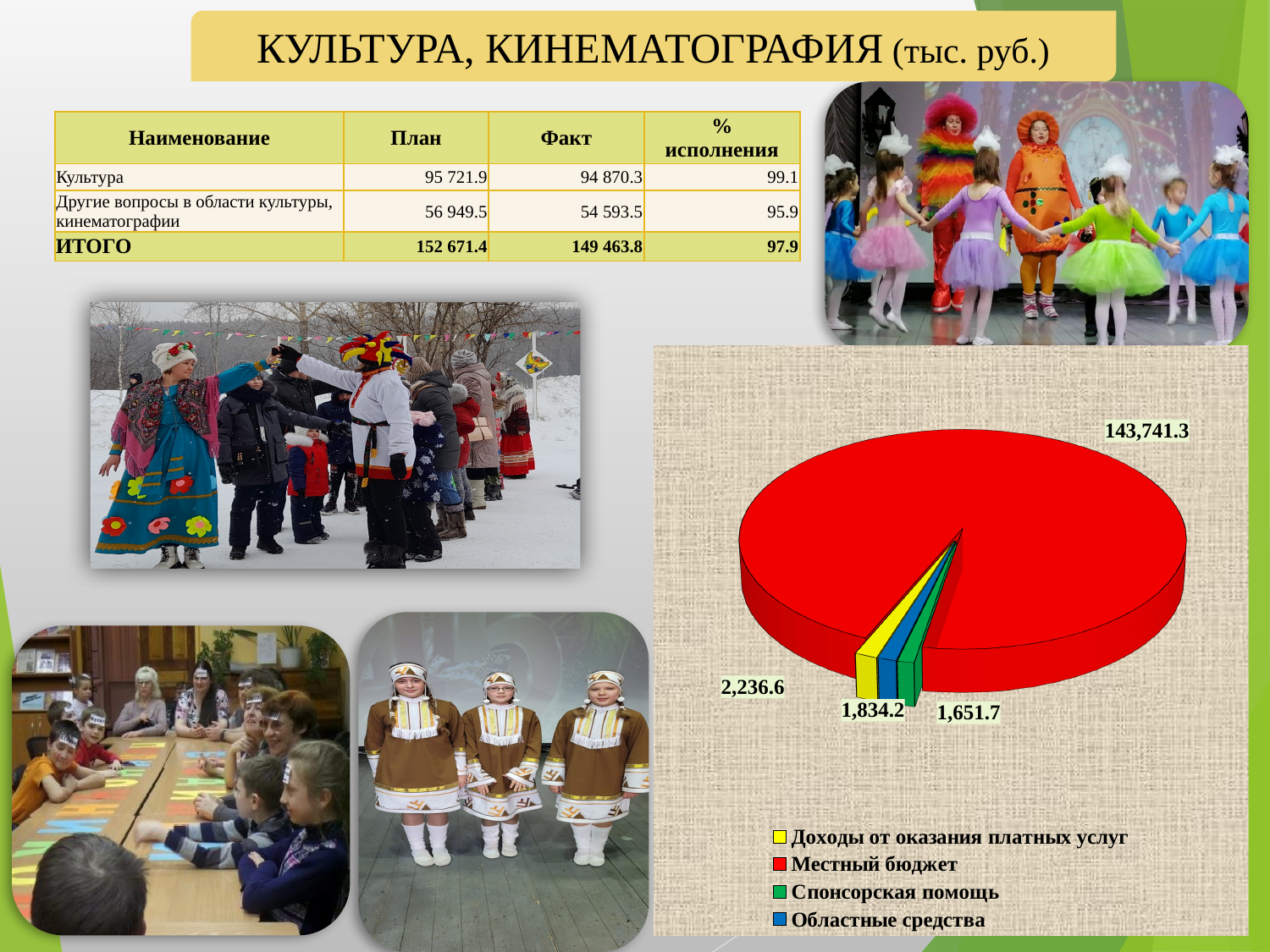
Which category has the smallest slice in the pie chart? Спонсорская помощь How many slices does the pie chart have? 4 What is the difference between the Местный бюджет value and the Доходы от оказания платных услуг value in the pie chart? 141,504.7 What colour is the Местный бюджет slice in the pie chart? red How many entries does the legend of the pie chart list? 4 What is the value of the Спонсорская помощь slice in the pie chart? 1,651.7 What colour is the Областные средства slice in the pie chart? blue What type of chart is shown on the slide? pie chart Which category has the largest slice in the pie chart? Местный бюджет What is the value of the Доходы от оказания платных услуг slice in the pie chart? 2,236.6 Which is larger in the pie chart: Доходы от оказания платных услуг or Областные средства? Доходы от оказания платных услуг What is the value of the Местный бюджет slice in the pie chart? 143,741.3